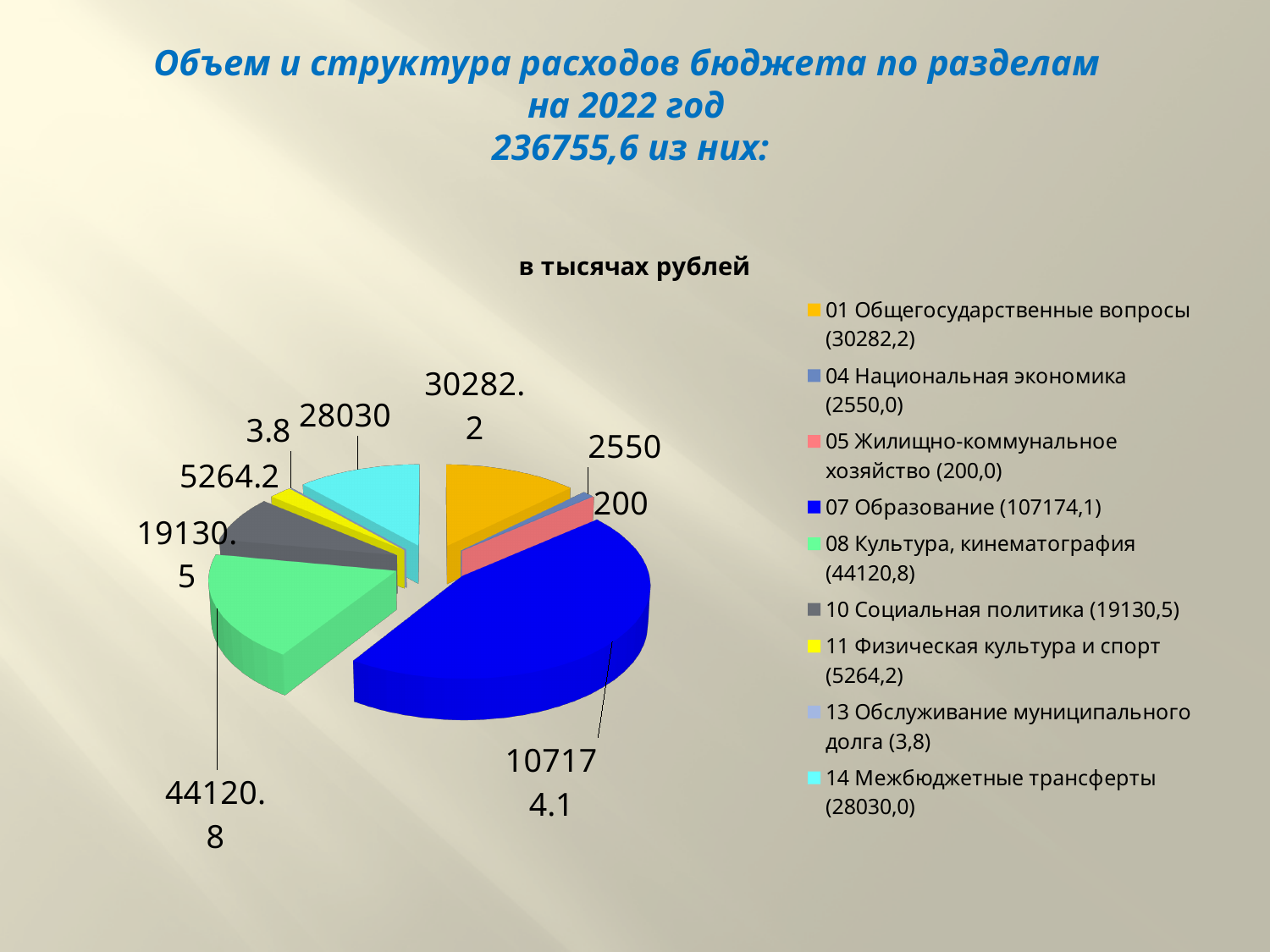
What kind of chart is shown on the slide? Pie chart How many categories are shown in the pie chart? 9 What is the difference between the values for 08 Культура, кинематография and 01 Общегосударственные вопросы? 13838.6 What unit is stated in the chart title? в тысячах рублей What is the value for 14 Межбюджетные трансферты? 28030 What is the value for 13 Обслуживание муниципального долга? 3.8 What is the value for 08 Культура, кинематография? 44120.8 Which is larger, the value for 04 Национальная экономика or the value for 05 Жилищно-коммунальное хозяйство? 04 Национальная экономика Which category has the largest slice of the pie? 07 Образование Which category has the smallest value? 13 Обслуживание муниципального долга What is the difference between the values for 14 Межбюджетные трансферты and 10 Социальная политика? 8899.5 What is the value for 07 Образование? 107174.1